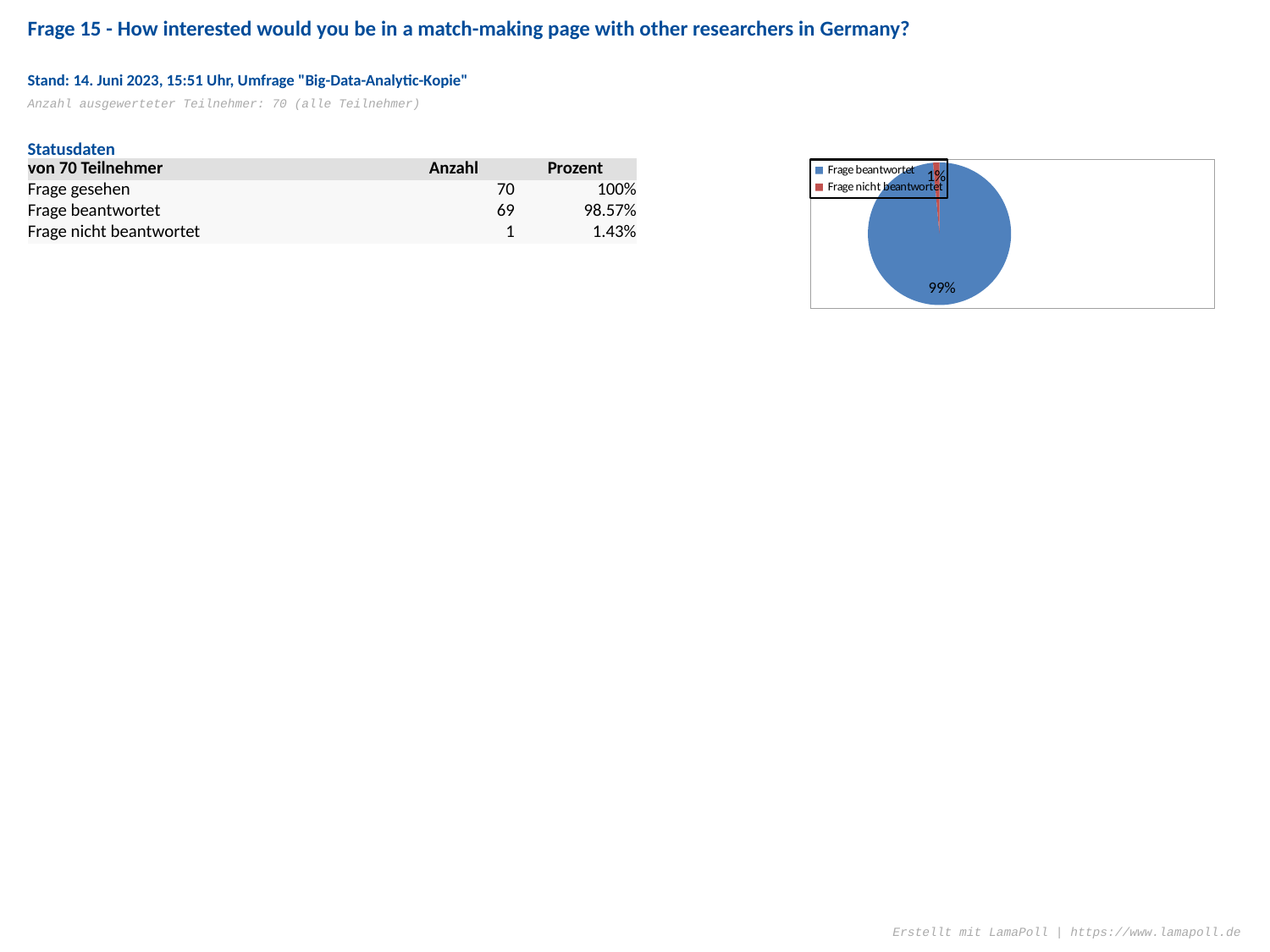
What percentage does the pie chart show for "Frage beantwortet"? 99% What colour is the "Frage nicht beantwortet" slice in the pie chart? red Which slice of the pie chart is the smallest? Frage nicht beantwortet How many entries does the pie chart's legend list? 2 How many slices does the pie chart have? 2 What colour is the "Frage beantwortet" slice in the pie chart? blue What is the difference in percentage points between the "Frage beantwortet" and "Frage nicht beantwortet" slices in the pie chart? 98 In the pie chart, which is larger: "Frage beantwortet" or "Frage nicht beantwortet"? Frage beantwortet What kind of chart is shown on the slide? pie chart What share of the pie does the "Frage beantwortet" slice take? 99% Which slice of the pie chart is the largest? Frage beantwortet What percentage does the pie chart show for "Frage nicht beantwortet"? 1%